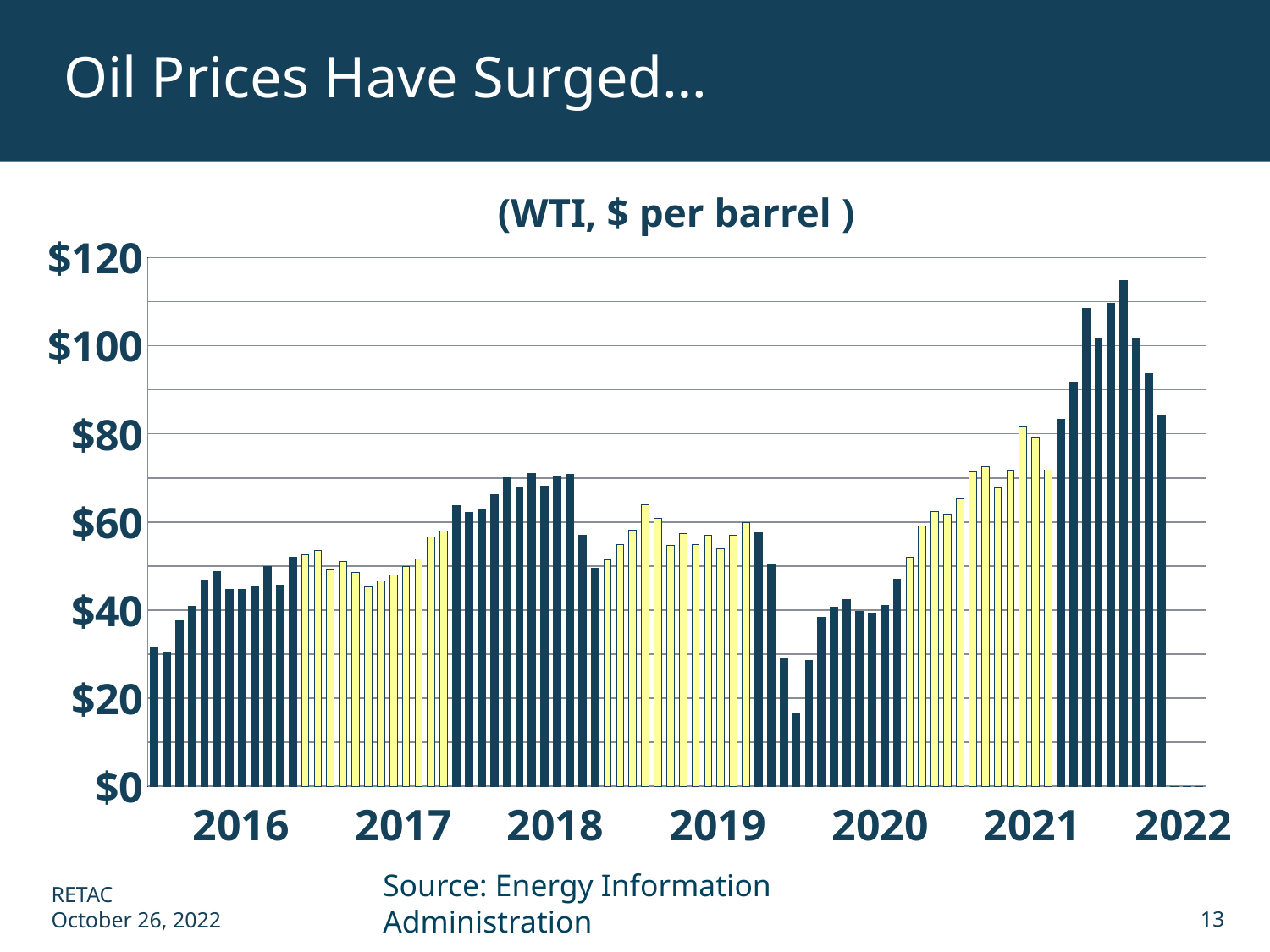
Is the first bar in 2016 greater or less than $40? less What kind of chart is shown on the slide? bar chart Which year contains the shortest bar in the chart? 2020 Which is taller: the tallest bar in 2018 or the tallest bar in 2022? 2022 Which year contains the tallest bar in the chart? 2022 What source is cited for the chart? Energy Information Administration Is the tallest bar in 2018 greater or less than $60? greater Is the tallest bar in 2022 greater or less than $100? greater What is the subtitle printed above the chart? (WTI, $ per barrel ) How many year labels appear along the x axis? 7 Do the bars generally rise or fall from the low point in 2020 to the peak in 2022? rise